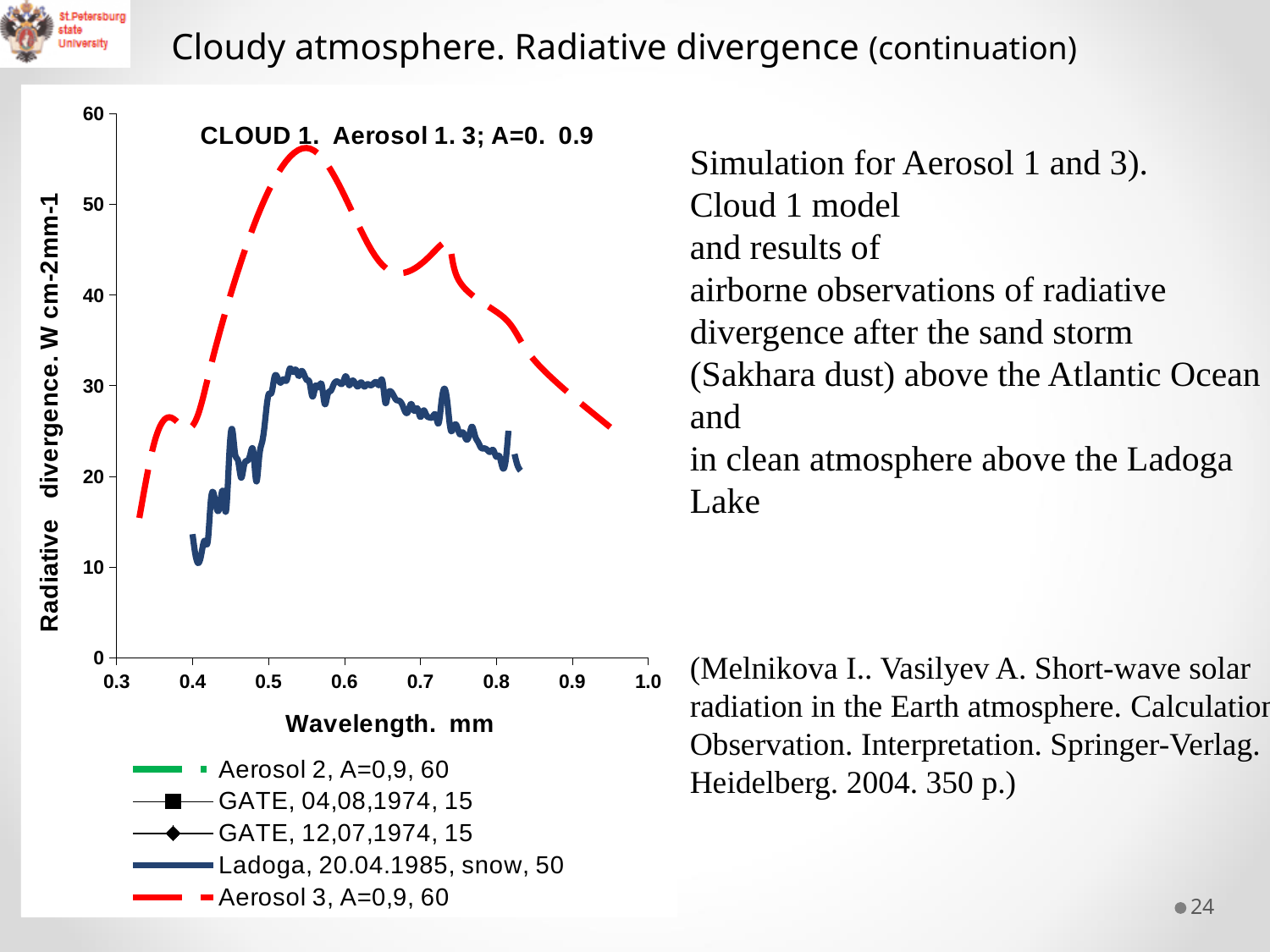
Does the Aerosol 3, A=0,9, 60 series rise or fall between wavelengths 0.55 and 0.95? fall Is the highest value of the Ladoga, 20.04.1985, snow, 50 series greater or less than 40? less What is the title of the chart? CLOUD 1. Aerosol 1. 3; A=0. 0.9 What kind of chart is shown on the slide? line chart Is the value of the Aerosol 3, A=0,9, 60 series at wavelength 0.95 greater or less than 30? less How many series does the chart legend list? 5 Is the peak value of the Aerosol 3, A=0,9, 60 series greater or less than 50? greater What is the label of the x axis of the chart? Wavelength. mm Does the Ladoga, 20.04.1985, snow, 50 series rise or fall between wavelengths 0.4 and 0.5? rise Which of the two plotted series reaches the higher maximum value? Aerosol 3, A=0,9, 60 At wavelength 0.6, which series has the larger value: Aerosol 3, A=0,9, 60 or Ladoga, 20.04.1985, snow, 50? Aerosol 3, A=0,9, 60